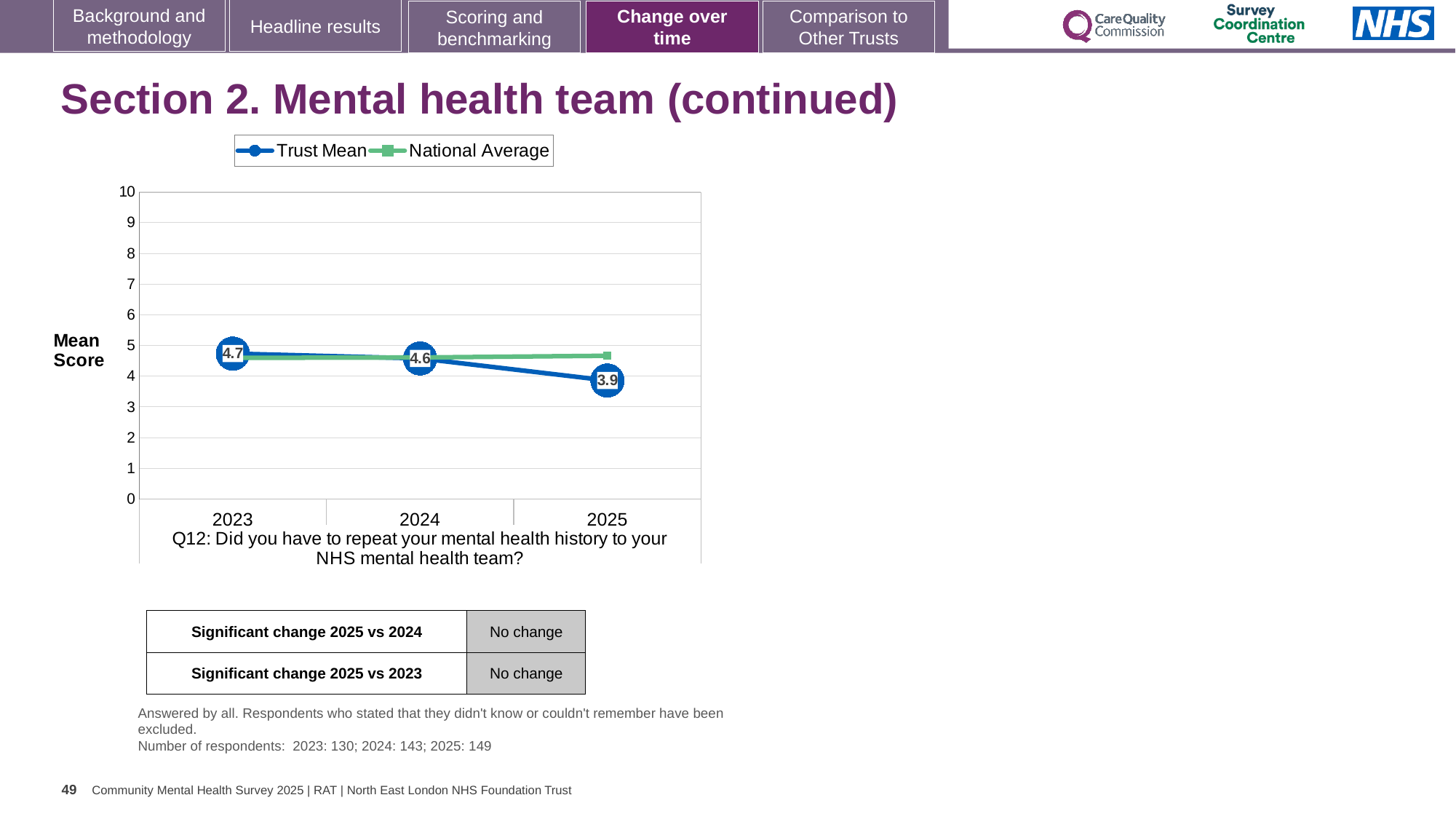
What is the Trust Mean score for 2023? 4.7 Does the Trust Mean rise or fall from 2023 to 2025? Fall In 2025, which is larger: the Trust Mean or the National Average? National Average How many series does the legend list? 2 In which year is the Trust Mean score highest? 2023 In which year is the Trust Mean score lowest? 2025 What is the Trust Mean score for 2024? 4.6 What is the difference between the Trust Mean score in 2023 and in 2025? 0.8 How many years are shown on the x axis? 3 What kind of chart is shown on the slide? Line chart What is the Trust Mean score for 2025? 3.9 Is the National Average value for 2025 greater or less than 4? greater